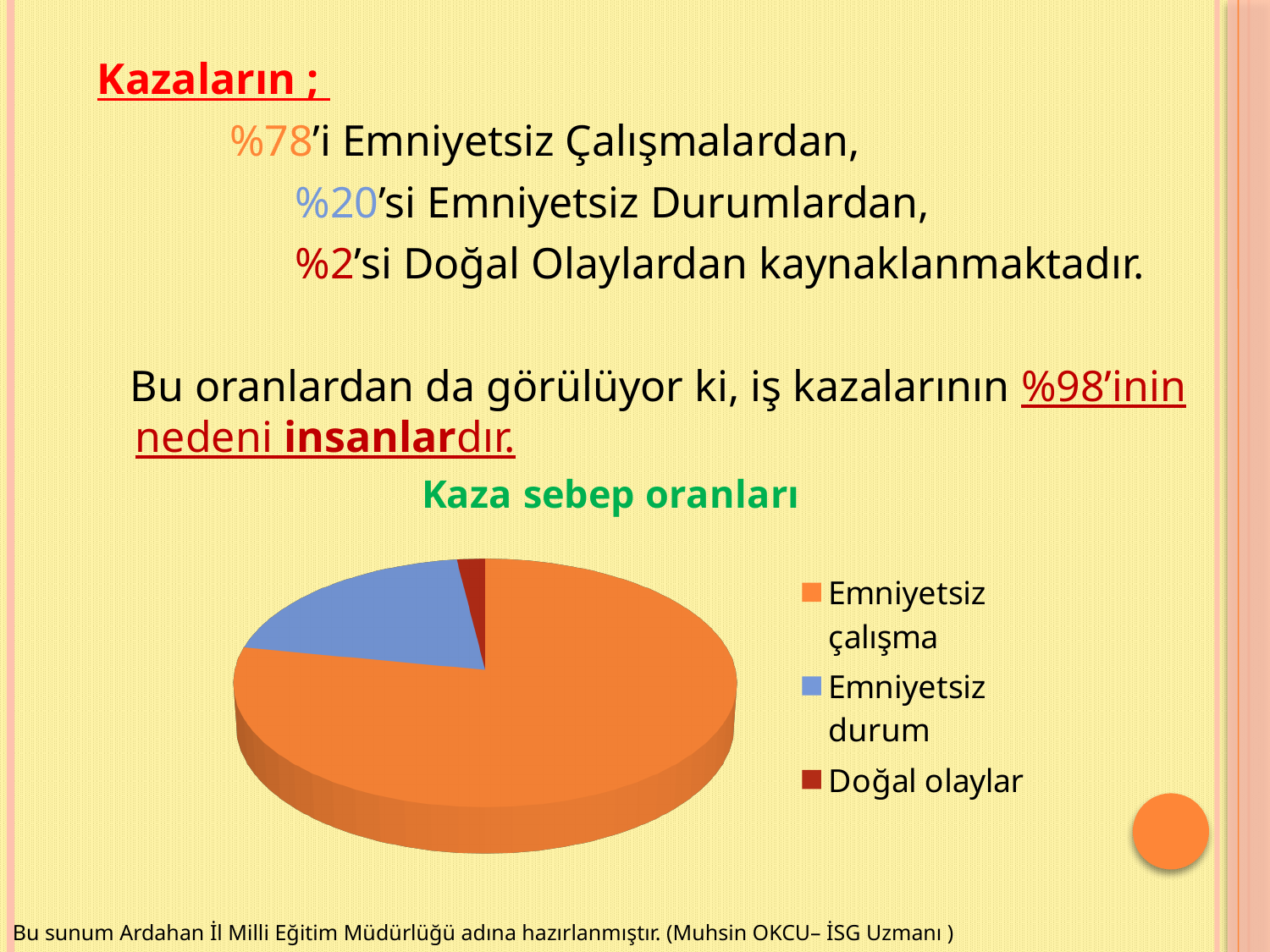
What share of the pie does Emniyetsiz çalışma represent, according to the slide? %78 Which category has the largest slice of the pie? Emniyetsiz çalışma What share of the pie does Doğal olaylar represent, according to the slide? %2 How many entries does the chart legend list? 3 What kind of chart is shown on the slide? pie chart Which slice is larger, Emniyetsiz durum or Doğal olaylar? Emniyetsiz durum What colour is the Emniyetsiz durum slice in the pie chart? blue Which slice is larger, Emniyetsiz çalışma or Emniyetsiz durum? Emniyetsiz çalışma How many slices does the pie chart have? 3 What is the title of the chart? Kaza sebep oranları Which category has the smallest slice of the pie? Doğal olaylar What share of the pie does Emniyetsiz durum represent, according to the slide? %20